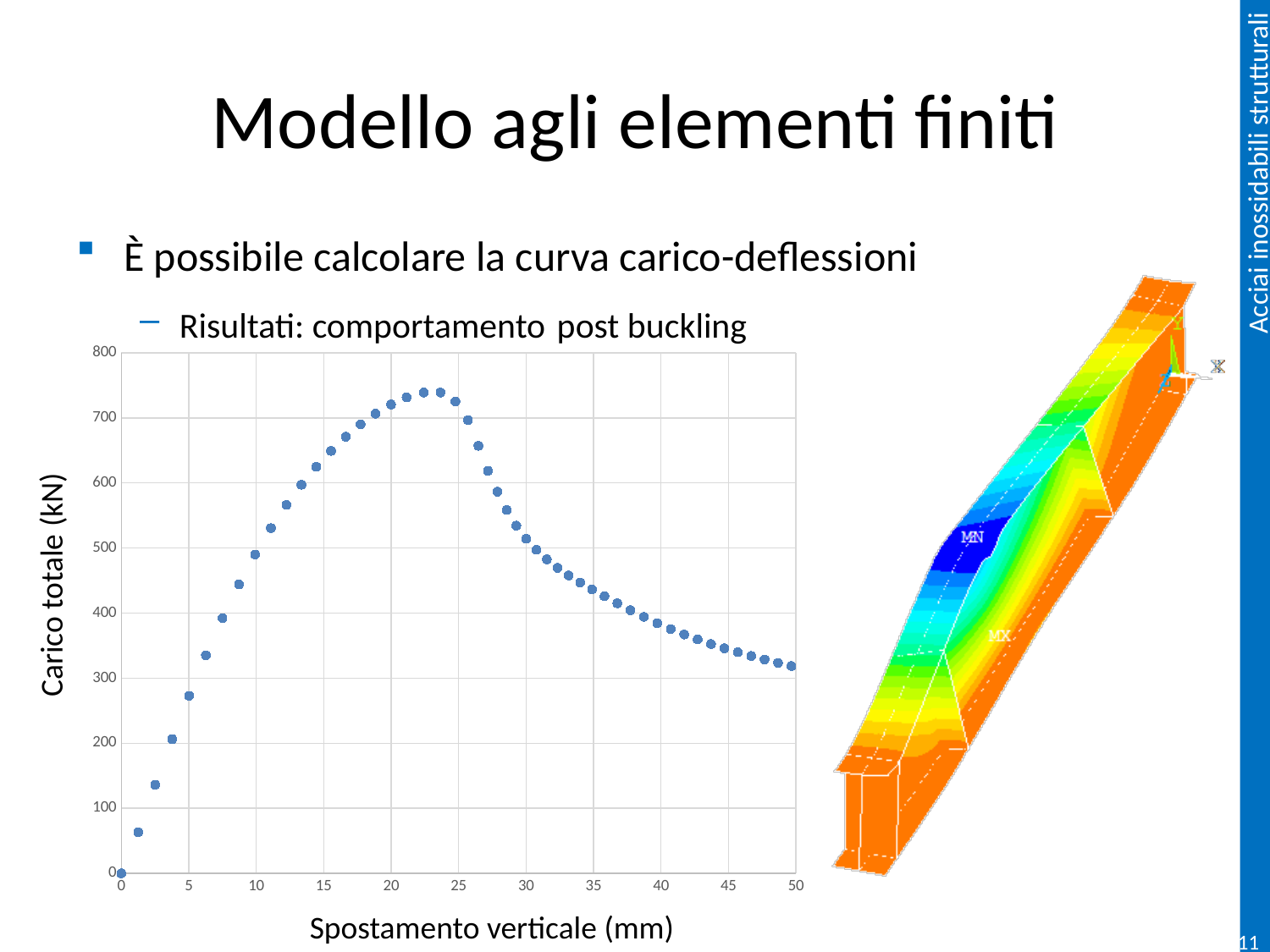
Does the curve reach its peak at a displacement less than or greater than 30 mm? less How does the load change as the vertical displacement increases from 0 mm to about 20 mm? it rises Is the load at a vertical displacement of 45 mm greater or less than 400 kN? less Is the load at a vertical displacement of 35 mm greater or less than 500 kN? less What is the label of the horizontal axis of the chart? Spostamento verticale (mm) What kind of chart is shown on the slide? scatter chart How does the load change as the vertical displacement increases from 30 mm to 50 mm? it falls What is the label of the vertical axis of the chart? Carico totale (kN)